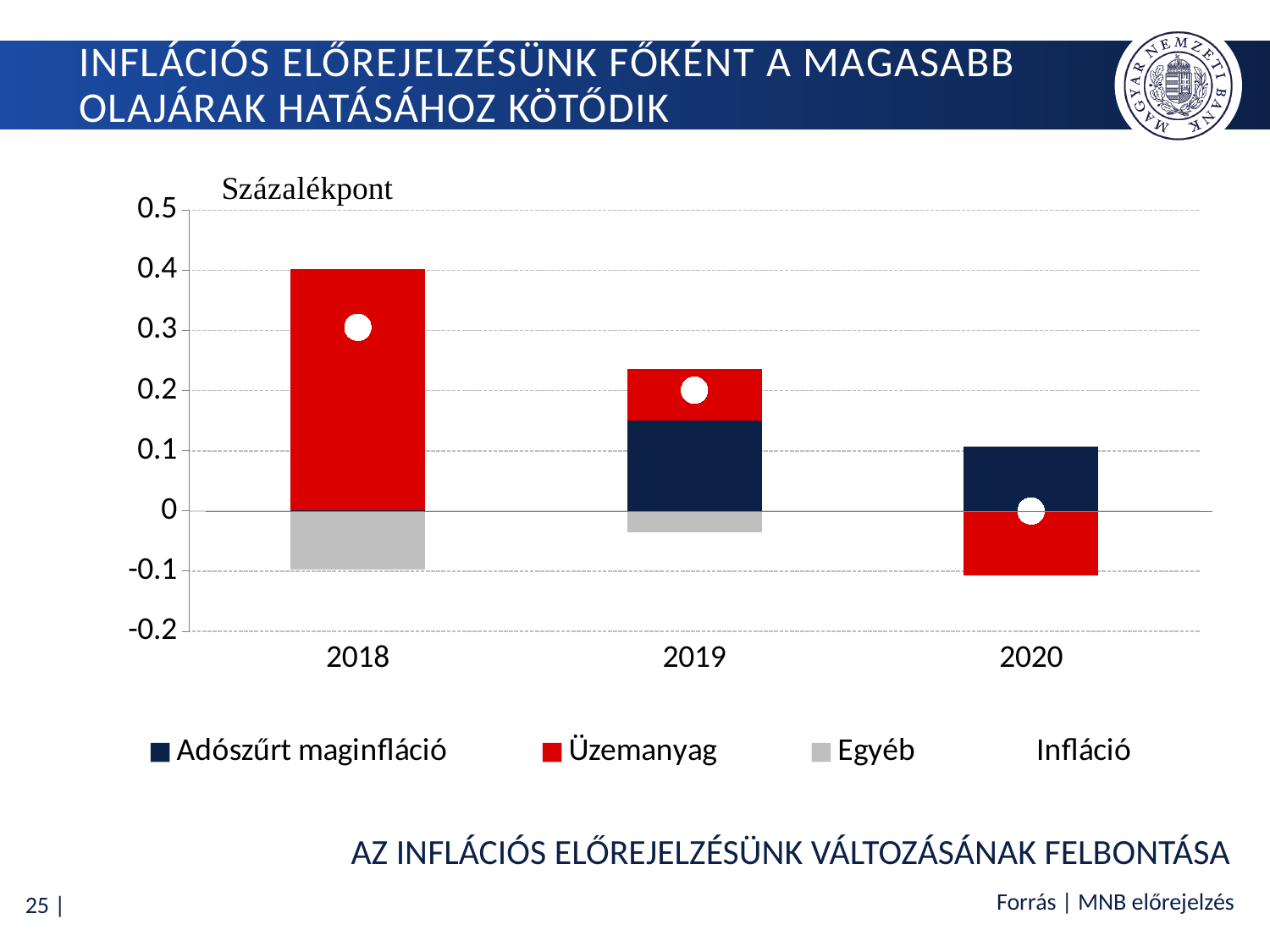
What kind of chart is shown on the slide? bar chart Is the Infláció marker for 2018 greater or less than 0.2? greater Is the Egyéb value for 2018 greater or less than 0? less What unit is shown above the vertical axis of the chart? Százalékpont Which year has the higher Üzemanyag value, 2018 or 2019? 2018 Is the Üzemanyag value for 2018 greater or less than 0.3? greater In which year is the Infláció marker highest? 2018 Does the Infláció marker rise or fall from 2018 to 2020? fall How many series does the chart legend list? 4 How many years are shown on the x axis of the chart? 3